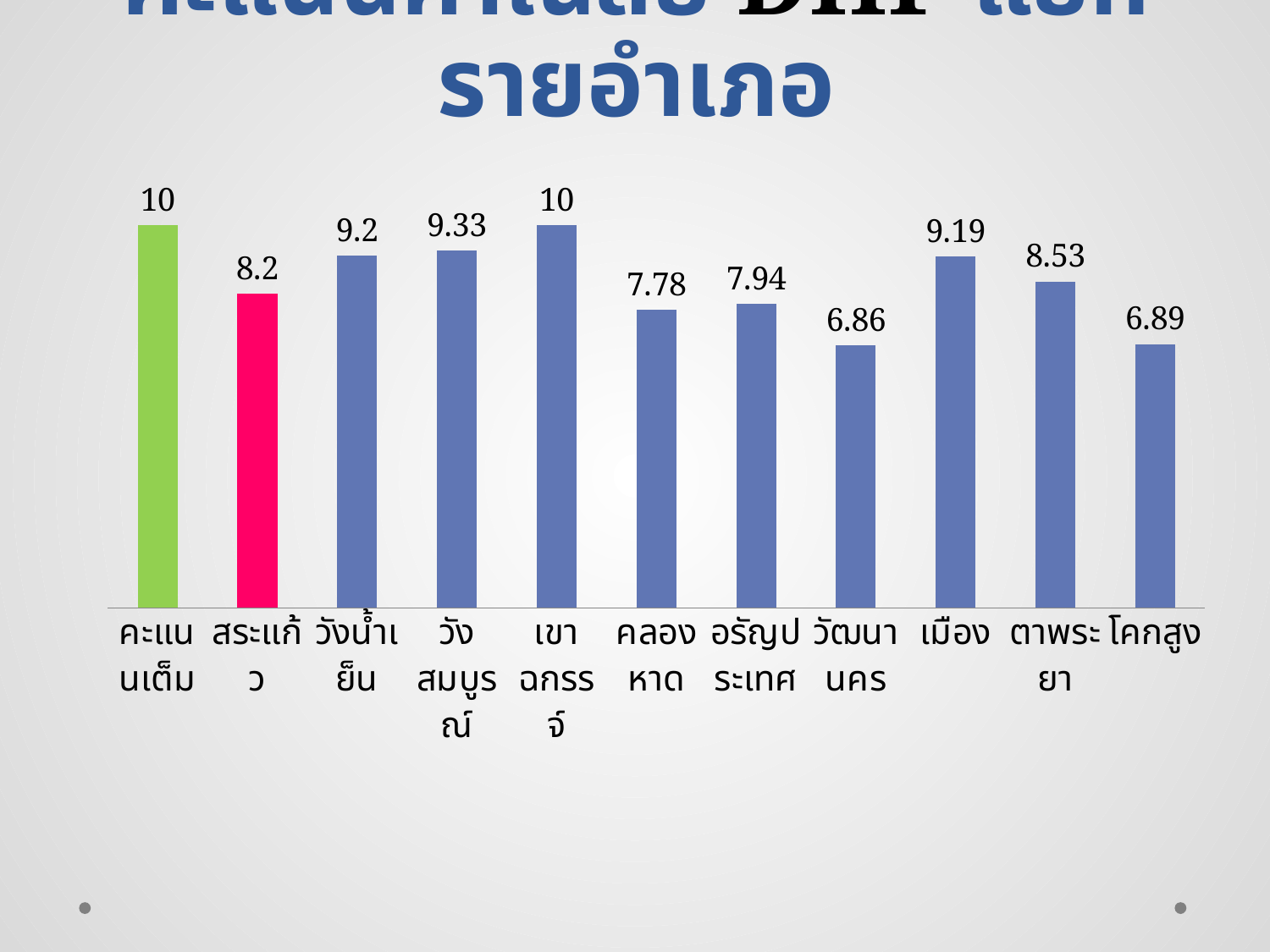
Which district, other than คะแนนเต็ม, has the highest value? เขาฉกรรจ์ How many bars are plotted in the chart? 11 What colour is the bar for สระแก้ว? pink What type of chart is shown on the slide? bar chart What is the difference between เมือง and ตาพระยา? 0.66 What is the value for เมือง? 9.19 What is the value for สระแก้ว? 8.2 Which category has the lowest value? วัฒนานคร What is the difference between คะแนนเต็ม and สระแก้ว? 1.8 Which is larger, the value for คลองหาด or อรัญประเทศ? อรัญประเทศ What is the value for วังสมบูรณ์? 9.33 What is the value for คลองหาด? 7.78